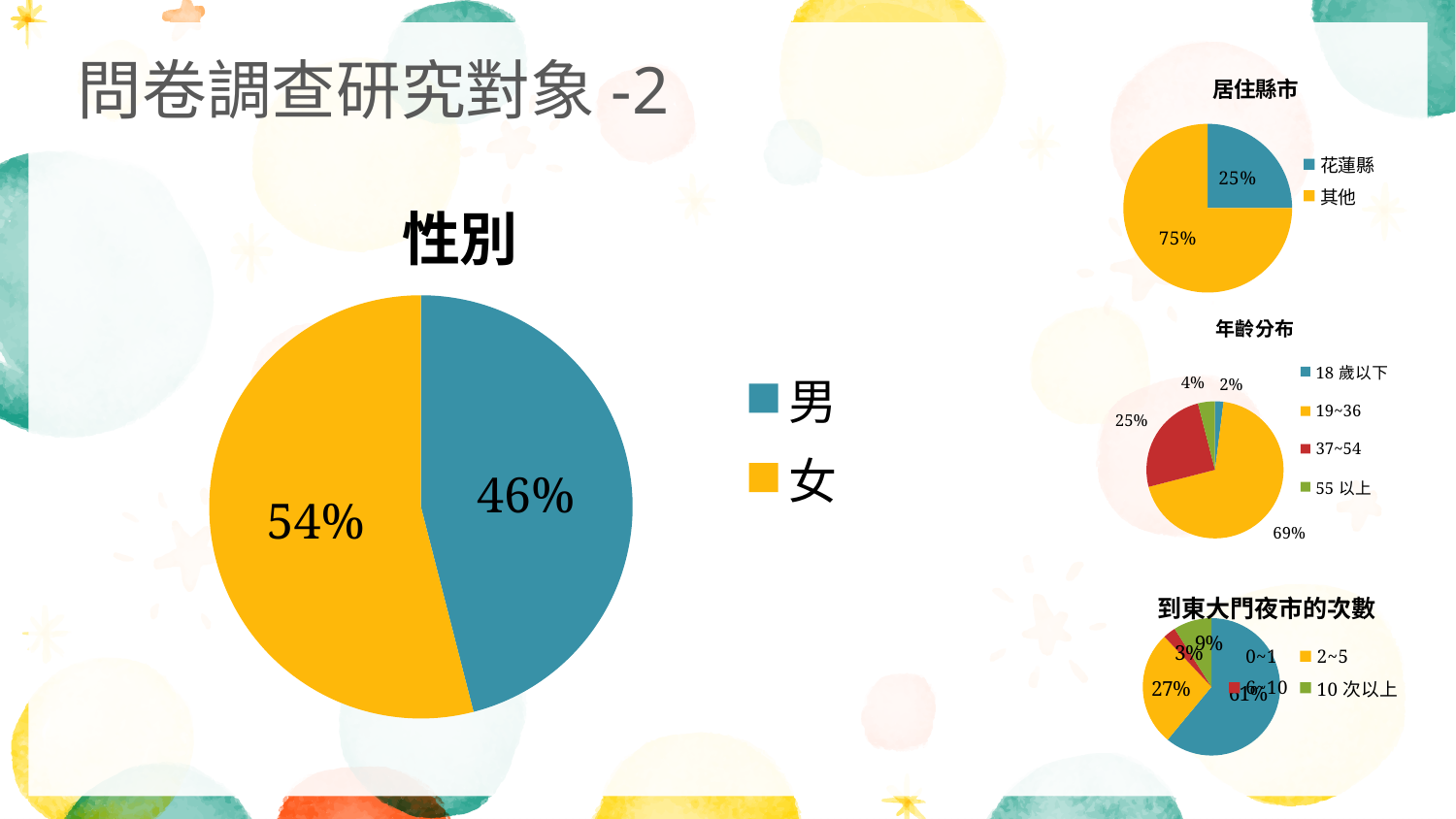
What kind of chart is the 性別 chart? Pie chart In the 年齡分布 chart, which age group has the smallest share? 18 歲以下 How many categories does the legend of the 年齡分布 chart list? 4 In the 年齡分布 chart, which age group has the largest share? 19~36 In the 居住縣市 chart, what percentage is 花蓮縣? 25% In the 到東大門夜市的次數 chart, what percentage is 2~5? 27% In the 性別 chart, what percentage is 男? 46% In the 年齡分布 chart, what percentage is 37~54? 25% In the 性別 chart, what percentage is 女? 54% In the 性別 chart, what is the difference between the 女 and 男 shares? 8% In the 性別 chart, which category has the larger share, 男 or 女? 女 In the 居住縣市 chart, what percentage is 其他? 75%